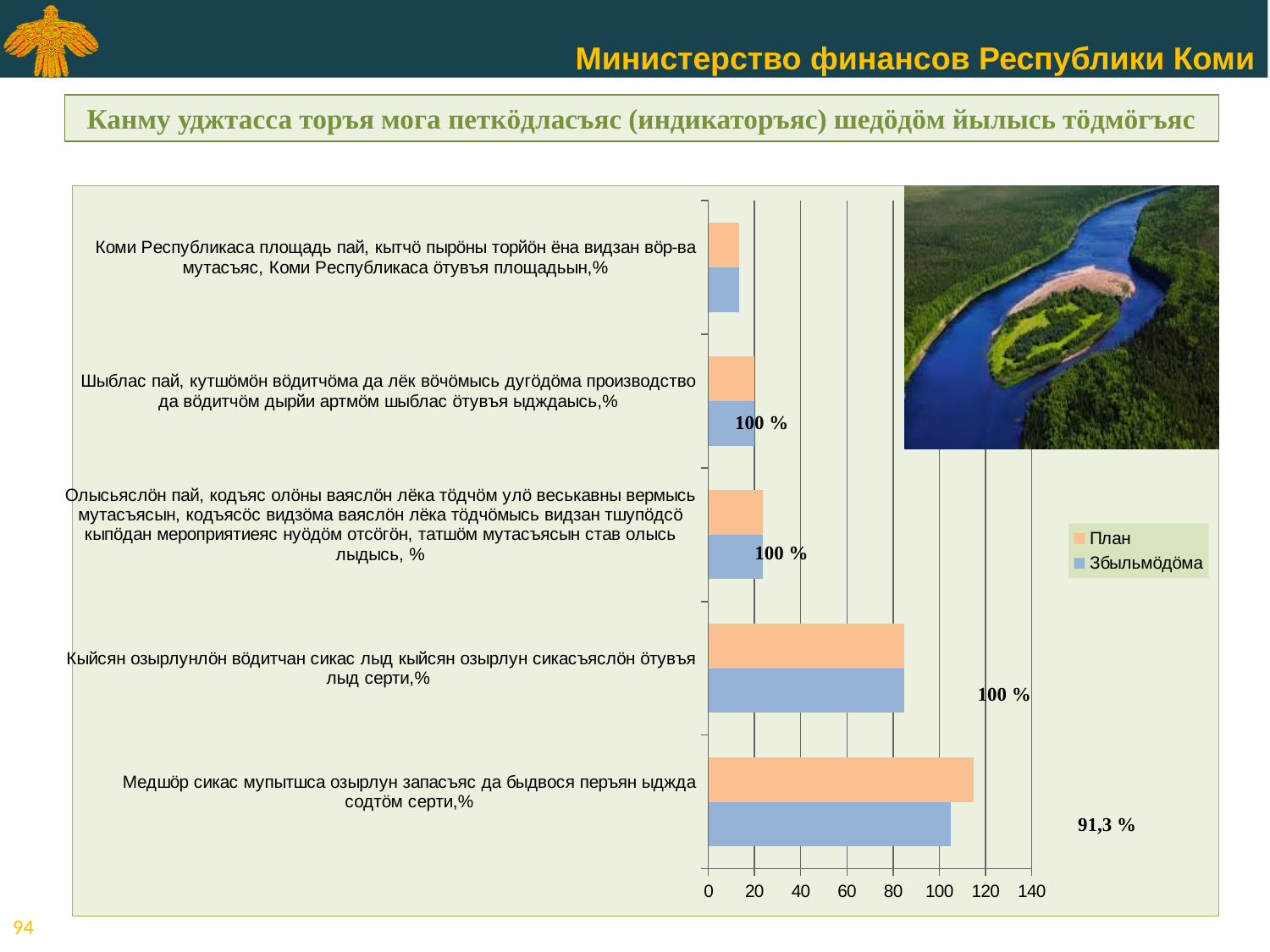
Is the Збыльмӧдӧма value for 'Кыйсян озырлунлӧн вӧдитчан сикас лыд...' greater or less than 100? less For 'Медшӧр сикас мупытшса озырлун запасъяс...', which is larger: the План value or the Збыльмӧдӧма value? План Which category has the highest План value? Медшӧр сикас мупытшса озырлун запасъяс да быдвося перъян ыджда содтӧм серти,% What kind of chart is shown on the slide? bar chart Is the План value for 'Коми Республикаса площадь пай...' greater or less than 20? less What are the two series named in the legend? План and Збыльмӧдӧма Which category has the lowest Збыльмӧдӧма value? Коми Республикаса площадь пай, кытчӧ пырӧны торйӧн ёна видзан вӧр-ва мутасъяс, Коми Республикаса ӧтувъя площадьын,% Which colour represents the План series? orange How many categories are plotted on the chart? 5 How many series does the chart legend list? 2 Is the Збыльмӧдӧма value for 'Олысьяслӧн пай, кодъяс олӧны ваяслӧн лёка тӧдчӧм улӧ...' greater or less than 40? less